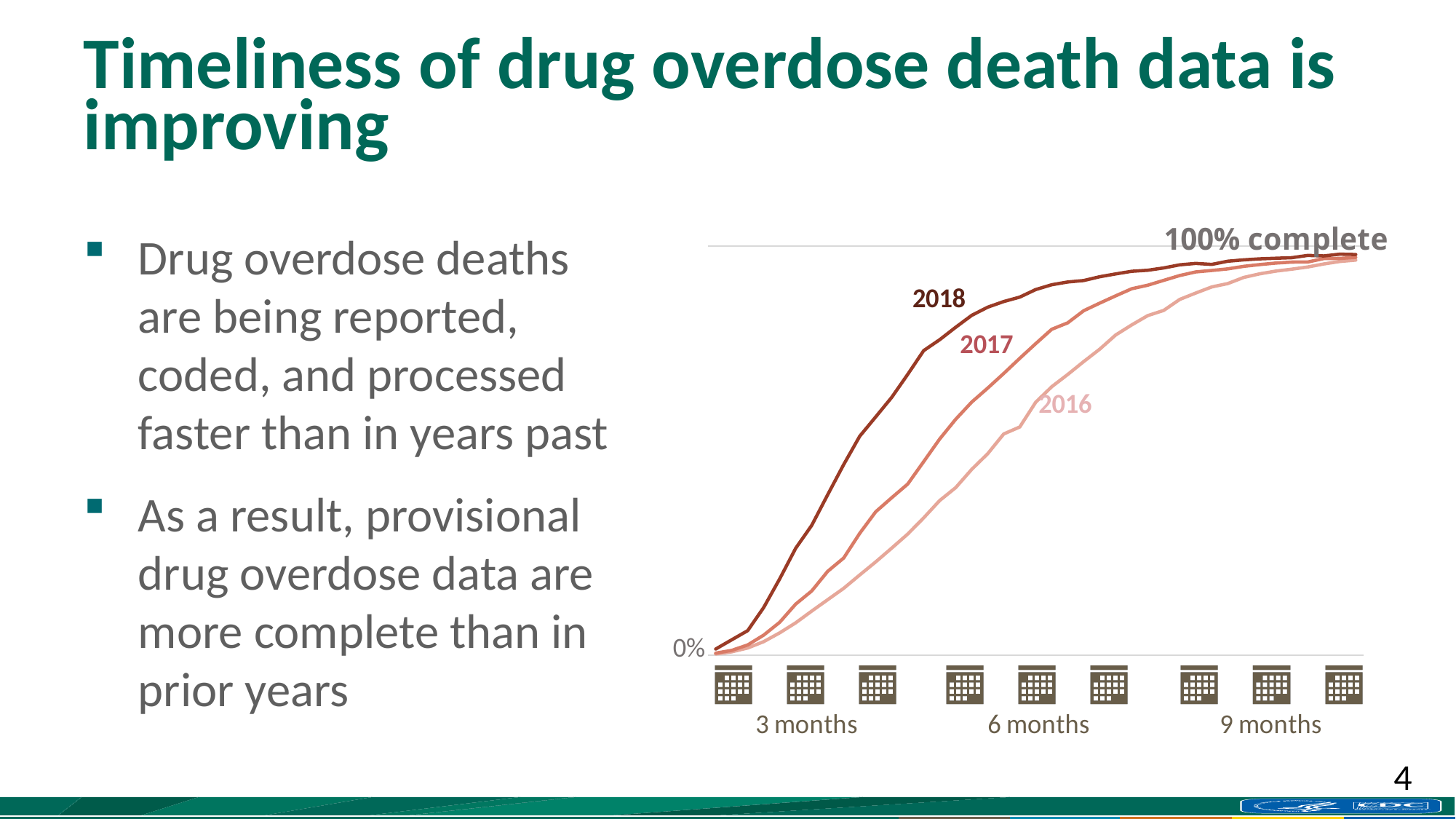
How many month labels are shown along the x axis? 3 Do the values for each year rise or fall as the number of months increases? rise Which year's line is the slowest to approach 100% complete? 2016 At 3 months, which year has the higher completeness, 2018 or 2016? 2018 Which year's line reaches high completeness the fastest? 2018 Which years are plotted as lines on the chart? 2016, 2017, 2018 What label is shown at the top of the y axis? 100% complete What kind of chart is shown on the slide? line chart How many series (years) are plotted on the chart? 3 At 6 months, which year has the lower completeness, 2017 or 2016? 2016 At 6 months, which year has the higher completeness, 2018 or 2017? 2018